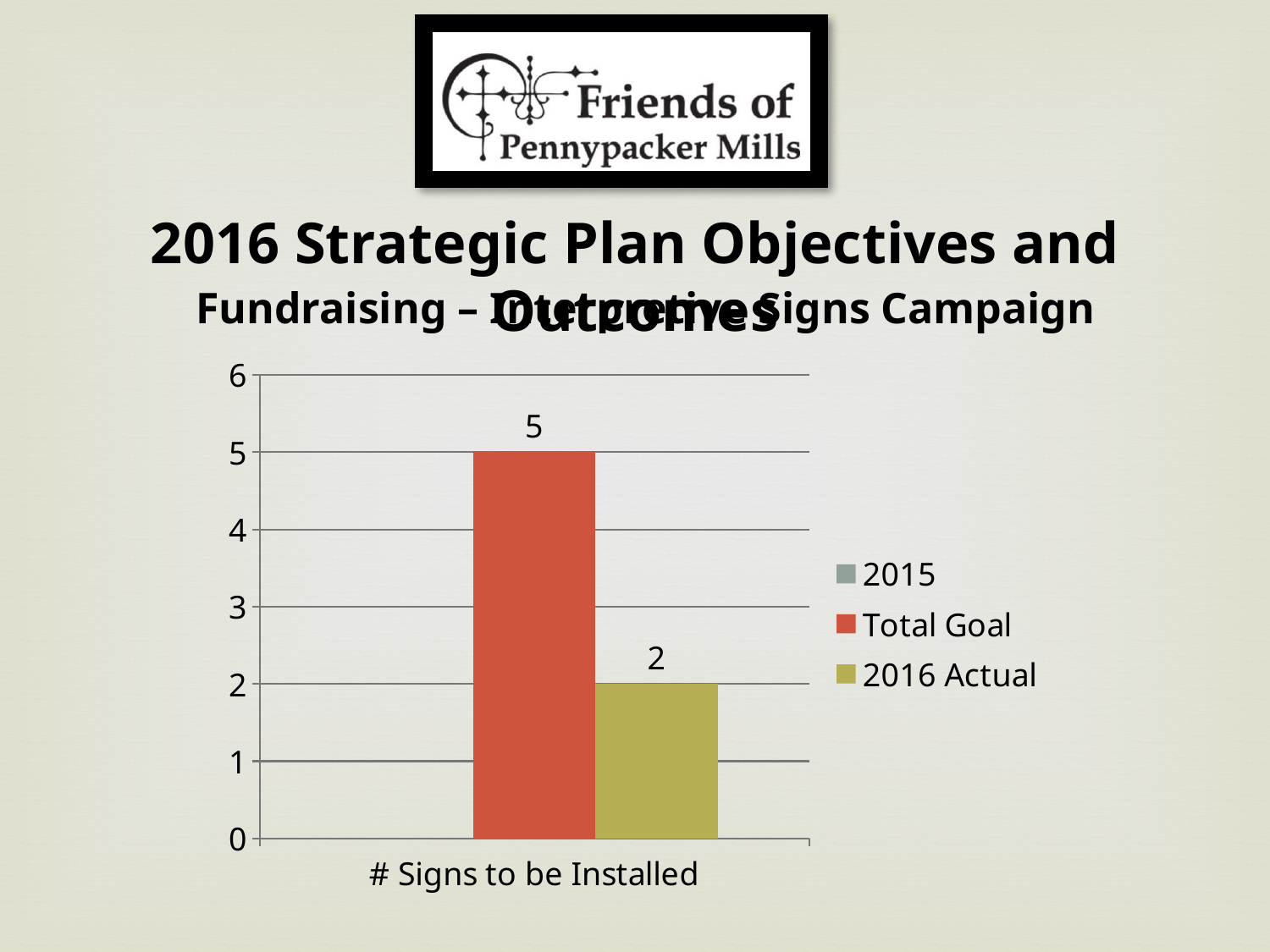
Is the 2016 Actual value for # Signs to be Installed greater or less than 3? less What is the 2016 Actual value for # Signs to be Installed? 2 Is the Total Goal value for # Signs to be Installed greater or less than 4? greater What is the Total Goal value for # Signs to be Installed? 5 What kind of chart is shown on the slide? Bar chart Which series has the higher value for # Signs to be Installed, Total Goal or 2016 Actual? Total Goal Which legend entry is shown in red? Total Goal How many categories are shown on the x axis of the chart? 1 What is the highest value shown on the y axis? 6 What is the label of the category on the x axis? # Signs to be Installed How many series does the legend list? 3 What is the difference between the Total Goal and the 2016 Actual values for # Signs to be Installed? 3